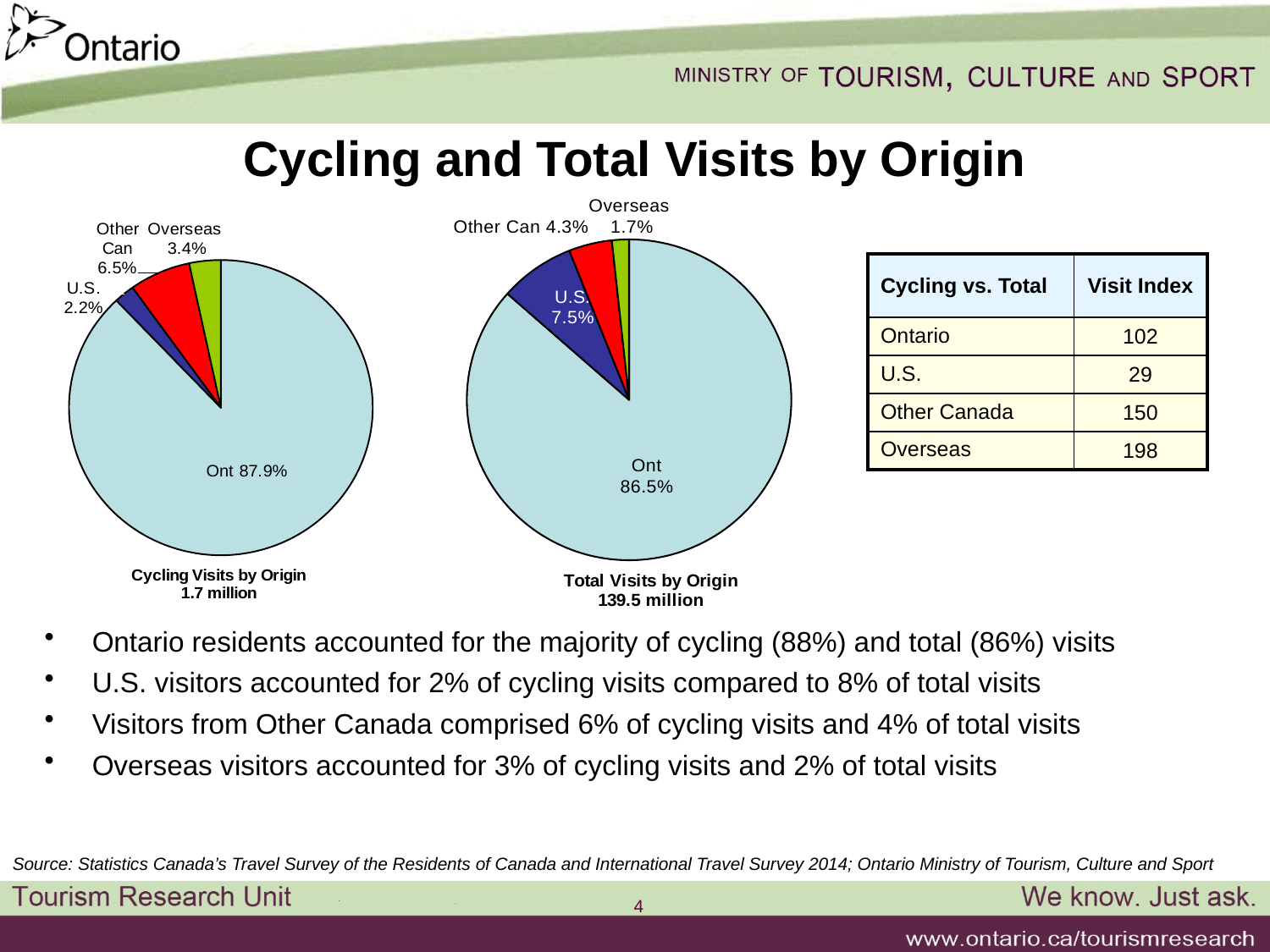
In the Cycling Visits by Origin chart, what is the difference between the Other Canada share and the Overseas share? 3.1% How many slices does the Total Visits by Origin chart have? 4 In the Cycling Visits by Origin chart, what share of visits is from Ontario? 87.9% In the Cycling Visits by Origin chart, which origin has the smallest share? U.S. What total number of visits is shown under the Total Visits by Origin chart? 139.5 million In the Total Visits by Origin chart, what share of visits is from the U.S.? 7.5% In the Cycling Visits by Origin chart, what share of visits is from Other Canada? 6.5% In the Total Visits by Origin chart, what share of visits is from Overseas? 1.7% In the Cycling Visits by Origin chart, which is larger: the U.S. share or the Overseas share? Overseas What type of chart is the Cycling Visits by Origin chart? Pie chart In the Total Visits by Origin chart, which origin has the smallest share? Overseas In the Total Visits by Origin chart, which origin has the largest share? Ont